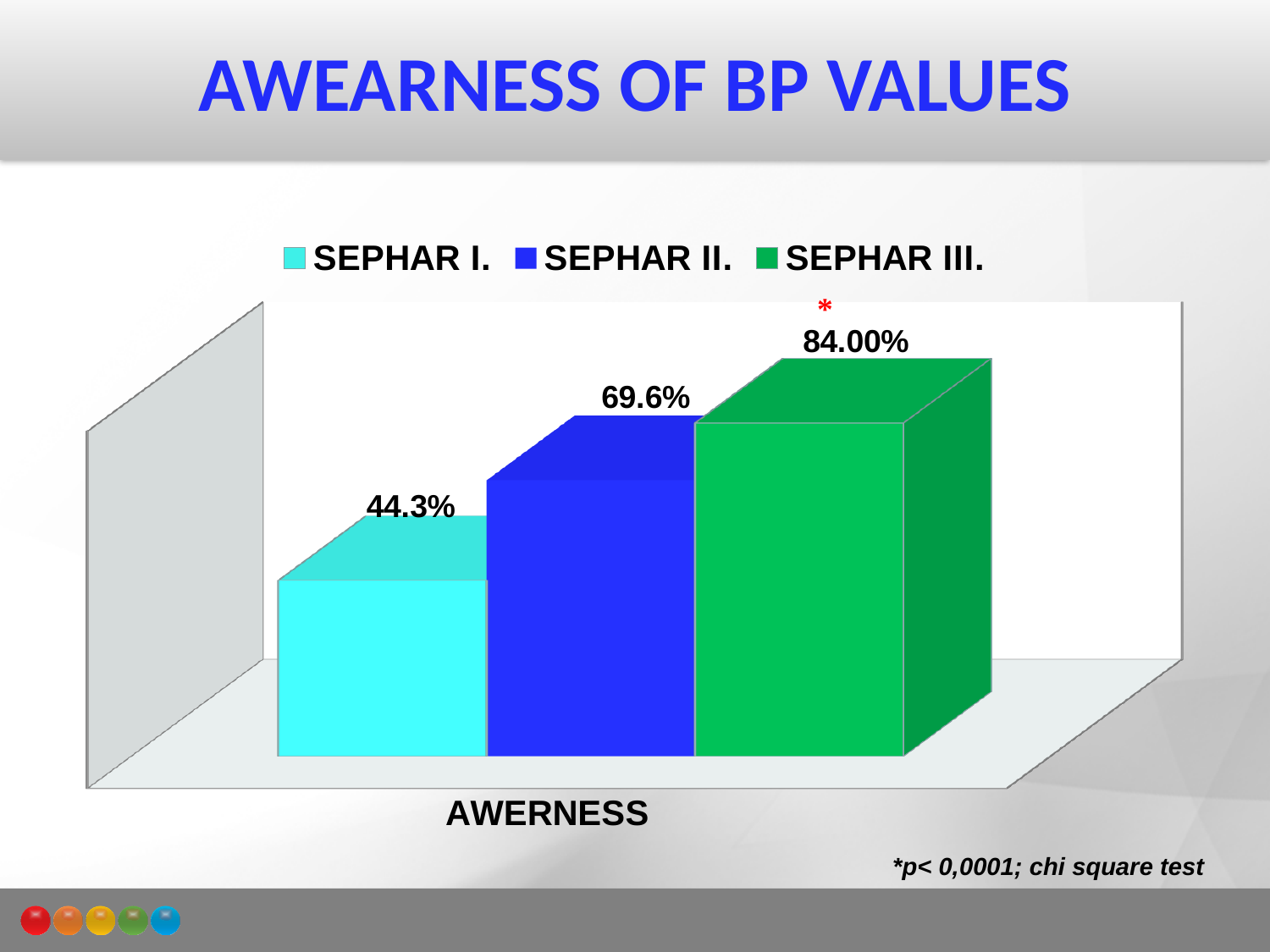
How many series does the legend list? 3 Which is larger, the value for SEPHAR II. or SEPHAR I.? SEPHAR II. What kind of chart is shown on the slide? bar chart What is the value for SEPHAR I.? 44.3% Which series has the lowest value? SEPHAR I. What is the difference between the values for SEPHAR III. and SEPHAR I.? 39.7% What is the value for SEPHAR III.? 84.00% What is the value for SEPHAR II.? 69.6% What is the title of the slide? AWEARNESS OF BP VALUES What is the category label shown on the x axis? AWERNESS Which series has the highest value? SEPHAR III. What is the difference between the values for SEPHAR II. and SEPHAR I.? 25.3%